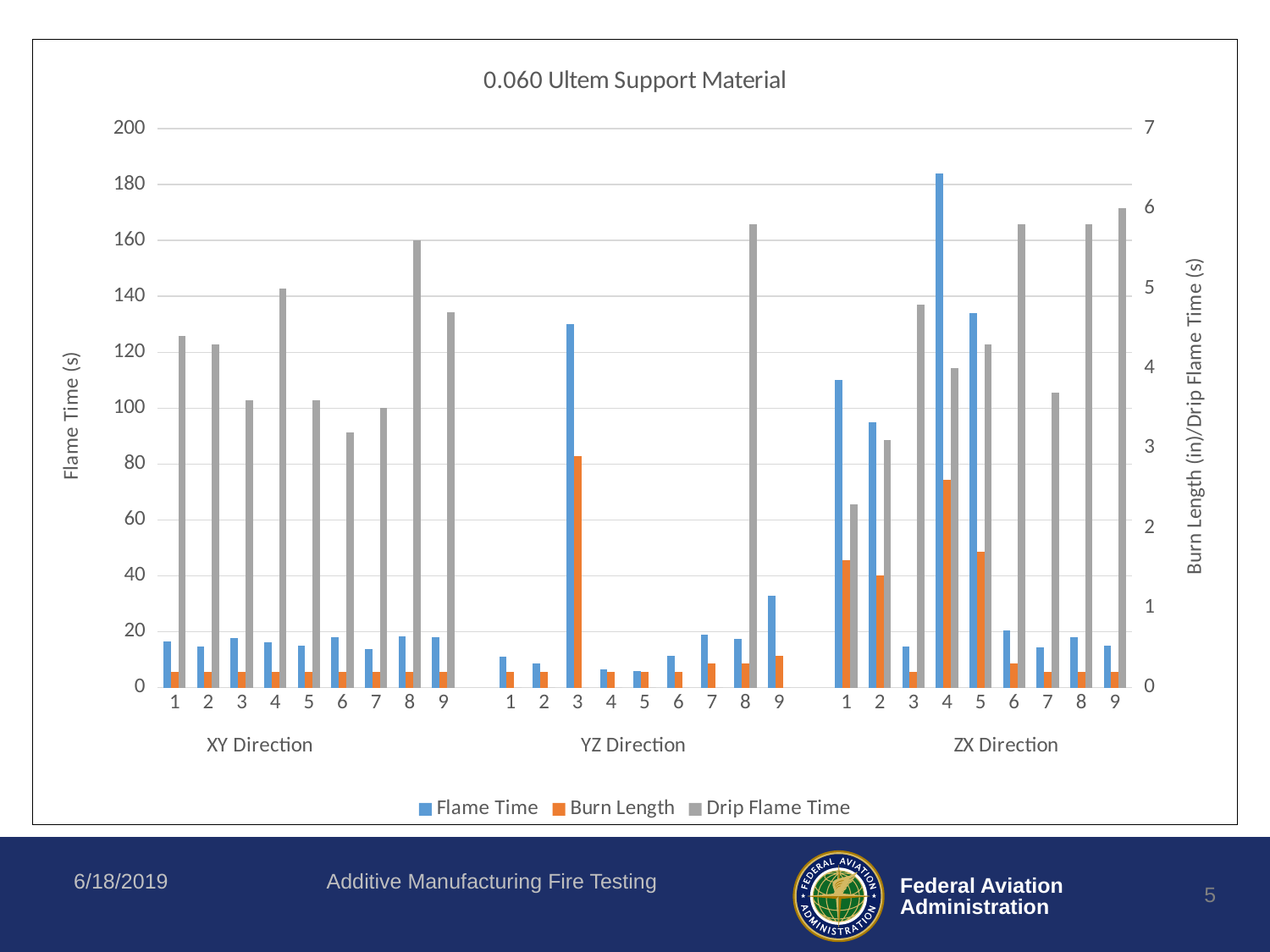
What is the title of the chart? 0.060 Ultem Support Material Which has the larger Drip Flame Time: specimen 8 or specimen 9 in the XY Direction? Specimen 8 Which specimen has the highest Flame Time across all directions? ZX Direction 4 Is the Burn Length for specimen 3 in the YZ Direction greater or less than 2? greater Is the Flame Time for specimen 4 in the ZX Direction greater or less than 160? greater Is the Flame Time for specimen 3 in the YZ Direction greater or less than 120? greater How many series does the legend list? 3 What type of chart is shown on the slide? Bar chart How many direction groups are shown along the x axis? 3 Which has the larger Flame Time: specimen 1 or specimen 2 in the ZX Direction? Specimen 1 How many specimens are plotted in the XY Direction group? 9